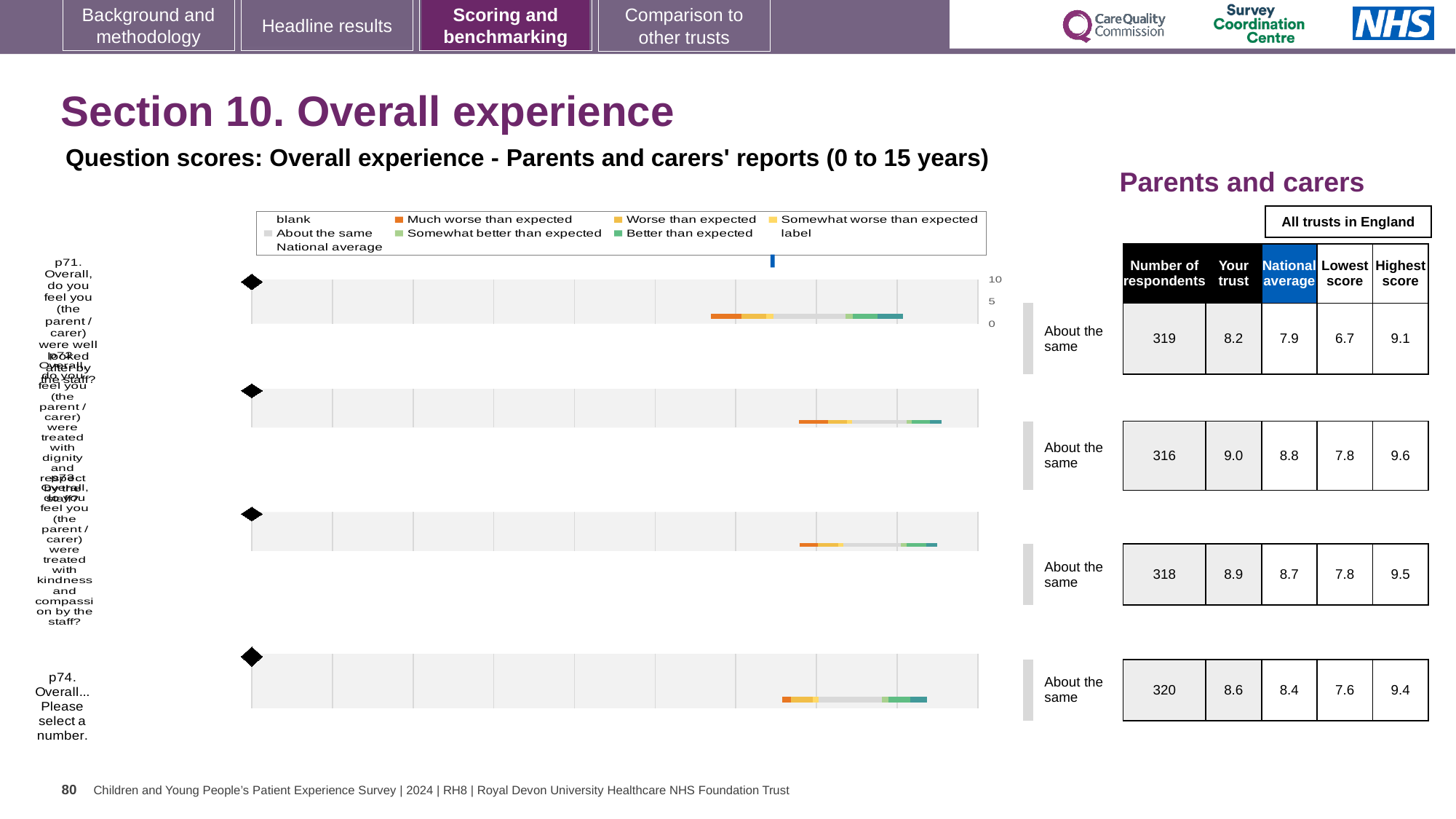
How many entries does the chart legend list? 9 What benchmark category is shown for all four rows? About the same Which row has the highest 'Your trust' score? p72 (9.0) What is the difference between the 'Your trust' score and the national average for the first row (p71)? 0.3 For the third row (p73), which is larger: the 'Your trust' score or the national average? Your trust Which row has the lowest 'Lowest score' value? p71 (6.7) What kind of chart is used to show the question scores on this slide? bar chart How many respondents are shown for the first row (p71)? 319 What is the highest score across all trusts in England for the second row (p72)? 9.6 What is the 'Your trust' score for the fourth row (p74. Overall... Please select a number)? 8.6 How many questions (rows) are plotted in the chart? 4 What is the title of the chart? Question scores: Overall experience - Parents and carers' reports (0 to 15 years)